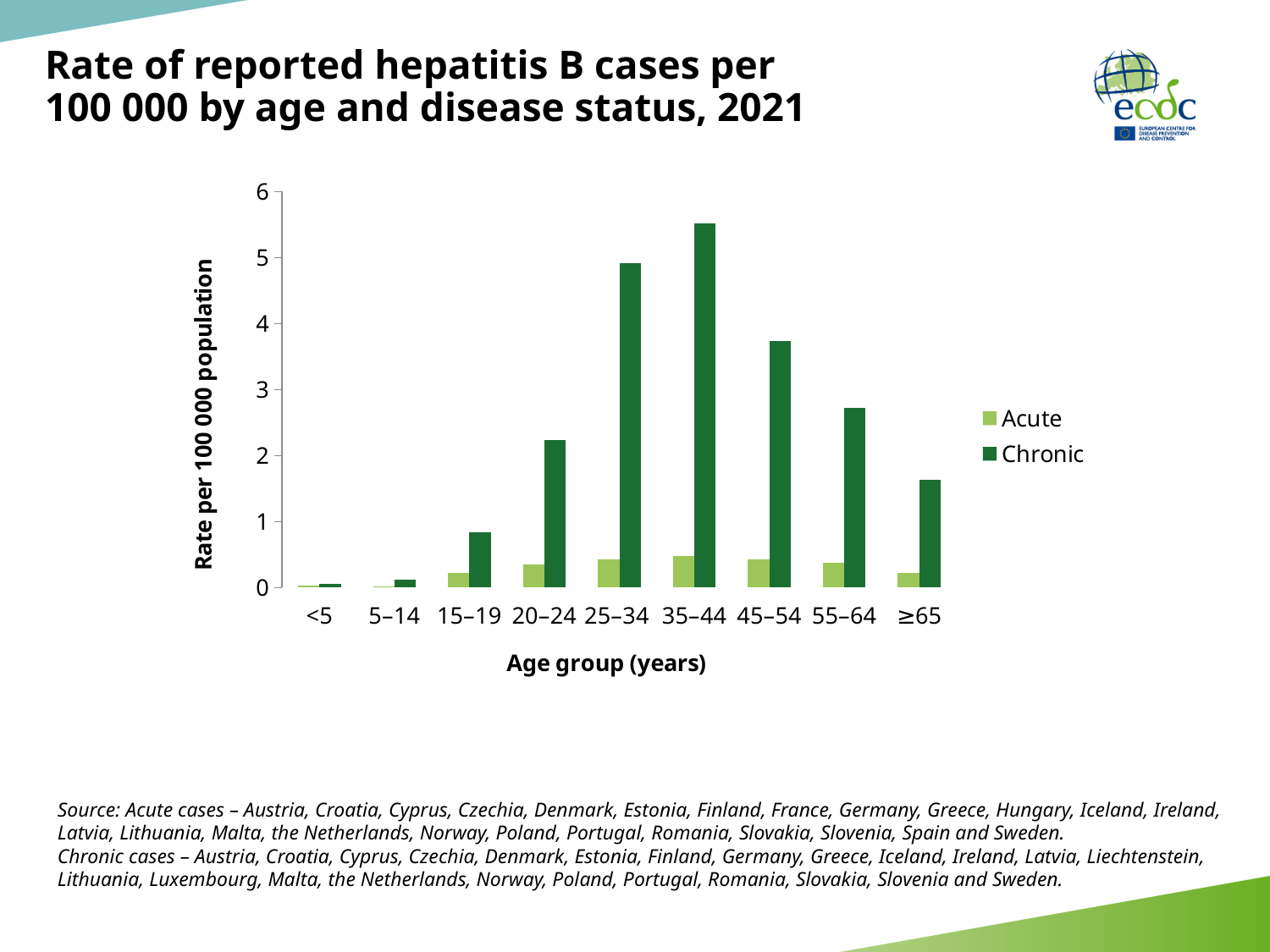
How many age groups are shown on the x axis? 9 Is the Chronic value for 20–24 greater or less than 2? greater What kind of chart is shown on the slide? Bar chart What is the label of the y axis? Rate per 100 000 population Which is larger for the 55–64 age group, the Acute or the Chronic rate? Chronic Which age group has the lowest Chronic rate? <5 Is the Chronic value for 45–54 greater or less than 4? less Which is larger, the Chronic rate for 25–34 or the Chronic rate for ≥65? 25–34 Is the Chronic value for 35–44 greater or less than 5? greater How many series does the legend list? 2 Which age group has the highest Chronic rate? 35–44